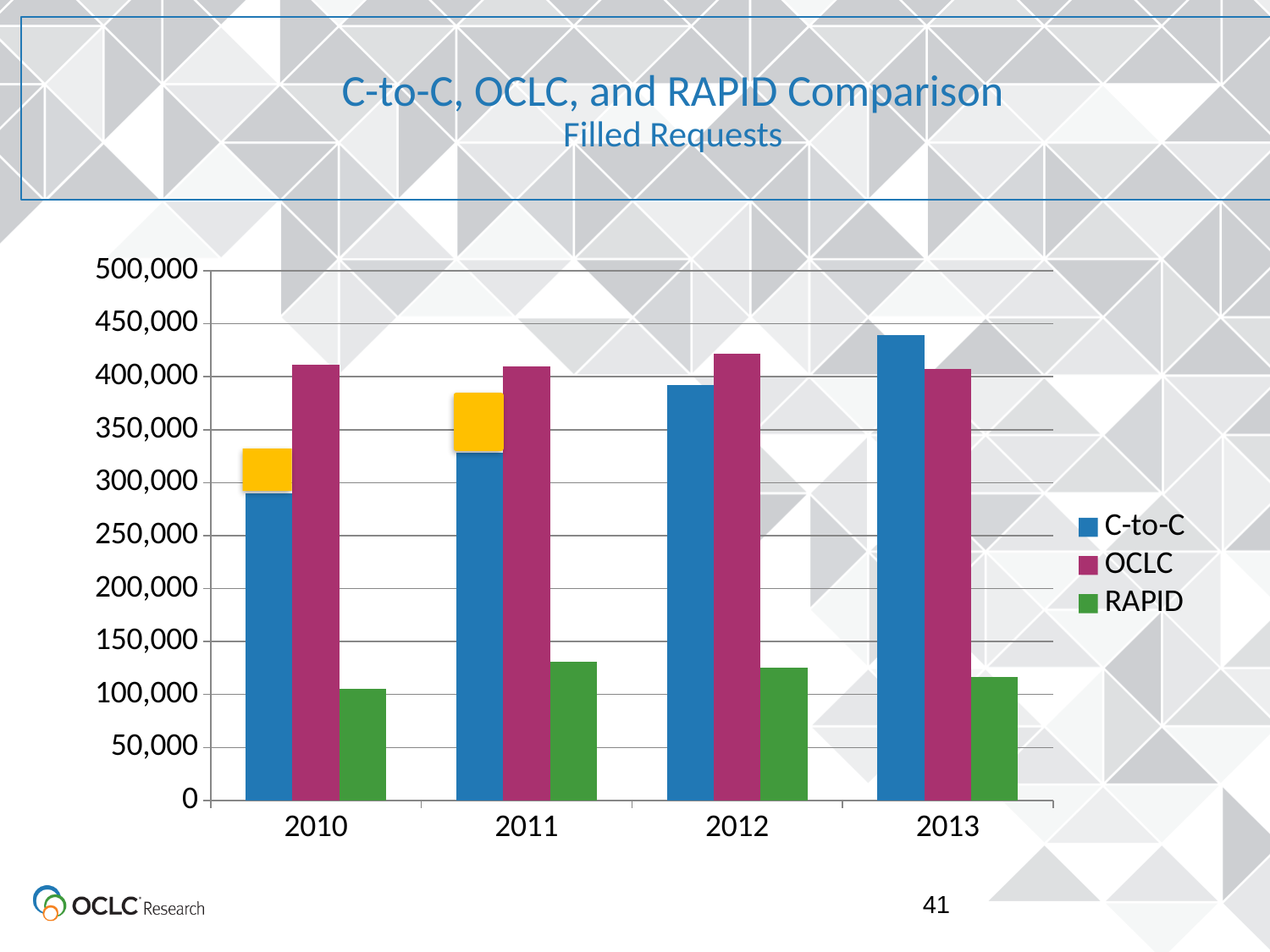
How many years are shown on the x axis? 4 Which series has the lowest filled requests in every year shown? RAPID Is the value for OCLC in 2012 greater or less than 400,000? greater In which year is the C-to-C bar the highest? 2013 How many series does the legend list? 3 In which year is the C-to-C bar the lowest? 2010 What kind of chart is shown on the slide? bar chart Do the C-to-C values rise or fall from 2010 to 2013? rise In 2011, which is larger, the C-to-C bar or the OCLC bar? OCLC Is the value for C-to-C in 2010 greater or less than 300,000? less In 2013, which is larger, the C-to-C bar or the OCLC bar? C-to-C Is the value for RAPID in 2011 greater or less than 150,000? less